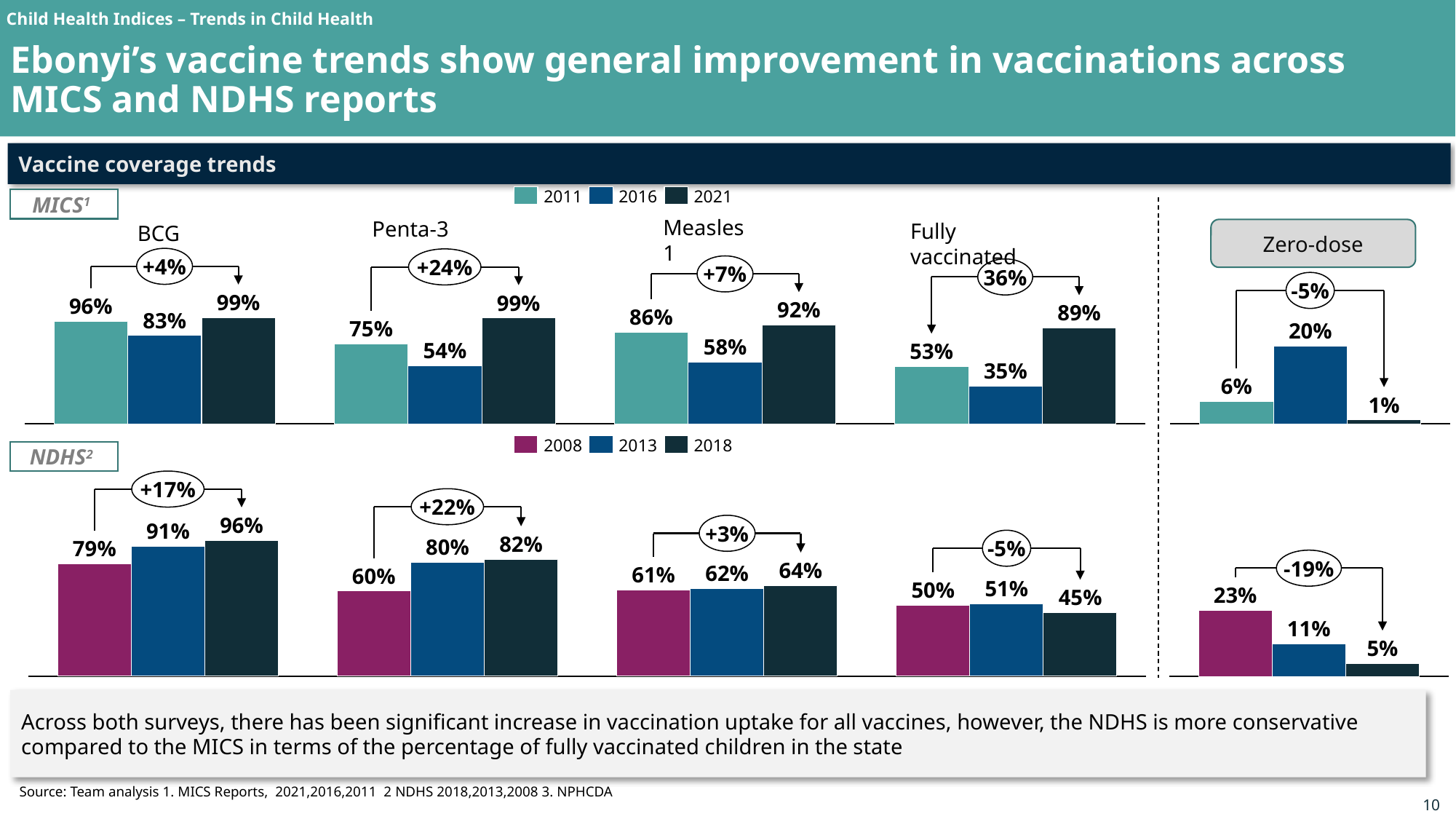
In the MICS Measles 1 chart, what is the difference between the 2021 and 2016 values? 34% In the MICS Penta-3 chart, what is the value for 2021? 99% In the NDHS Fully vaccinated chart, what is the value for 2018? 45% In the MICS Zero-dose chart, which year has the highest value? 2016 In the MICS BCG chart, what is the value for 2016? 83% In the NDHS Zero-dose chart, what is the value for 2008? 23% In the MICS Fully vaccinated chart, which year has the lowest value? 2016 In the NDHS Penta-3 chart, what is the difference between the 2013 and 2008 values? 20% In the NDHS Measles 1 chart, do the values rise or fall from 2008 to 2018? Rise In the NDHS BCG chart, which is larger, the 2008 value or the 2013 value? 2013 How many series does the legend for the NDHS row list? 3 What kind of chart is used for the MICS BCG data? Bar chart